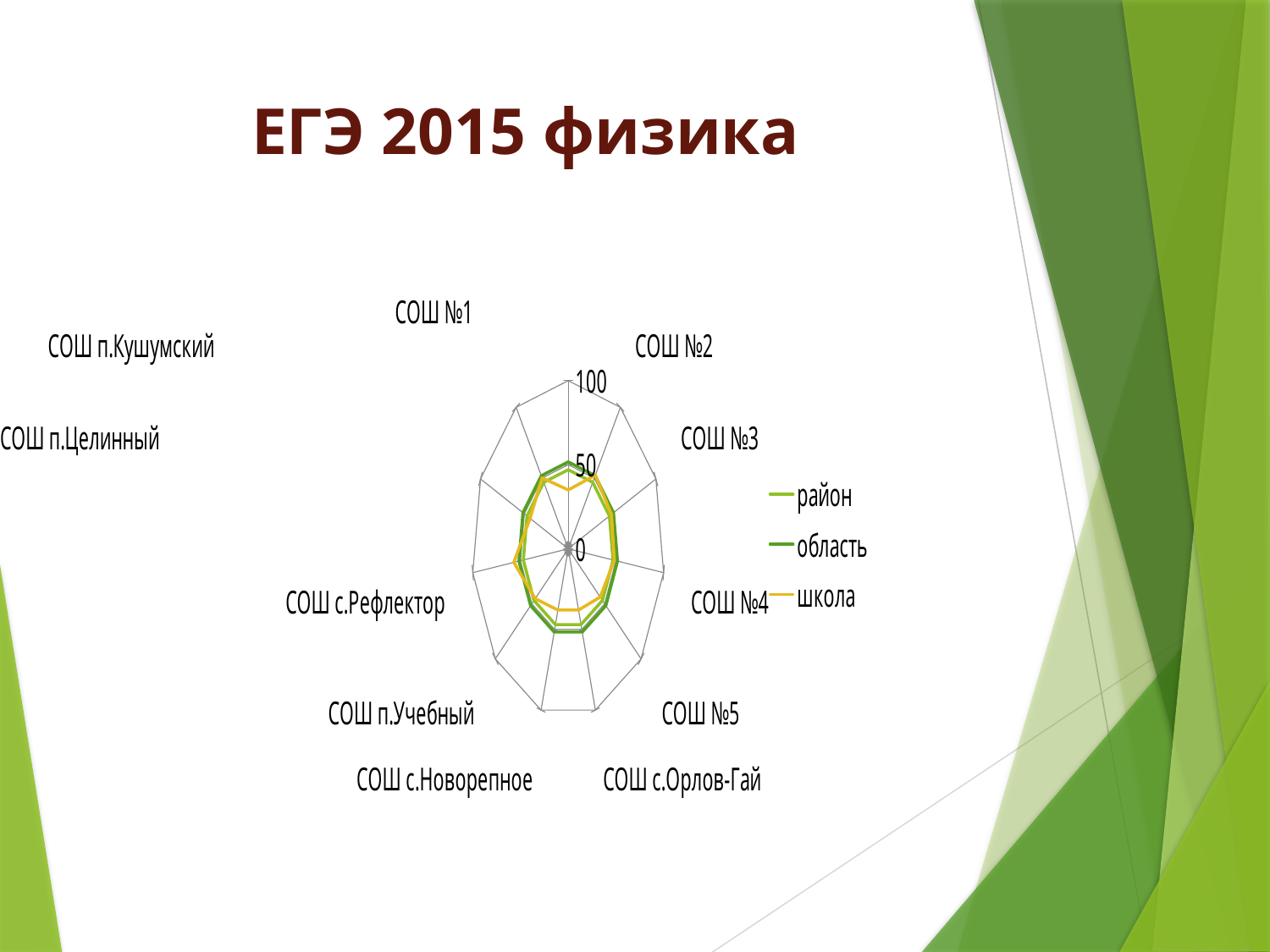
Is the value of the школа series for СОШ п.Учебный greater or less than 100? less What is the maximum value shown on the chart's radial axis? 100 Is the value of the школа series for СОШ №1 greater or less than 100? less Which series are listed in the chart legend? район, область, школа Is the value of the район series for СОШ с.Рефлектор greater or less than 100? less How many series does the legend list? 3 What is the title of the slide with the chart? ЕГЭ 2015 физика What kind of chart is shown on the slide? radar chart